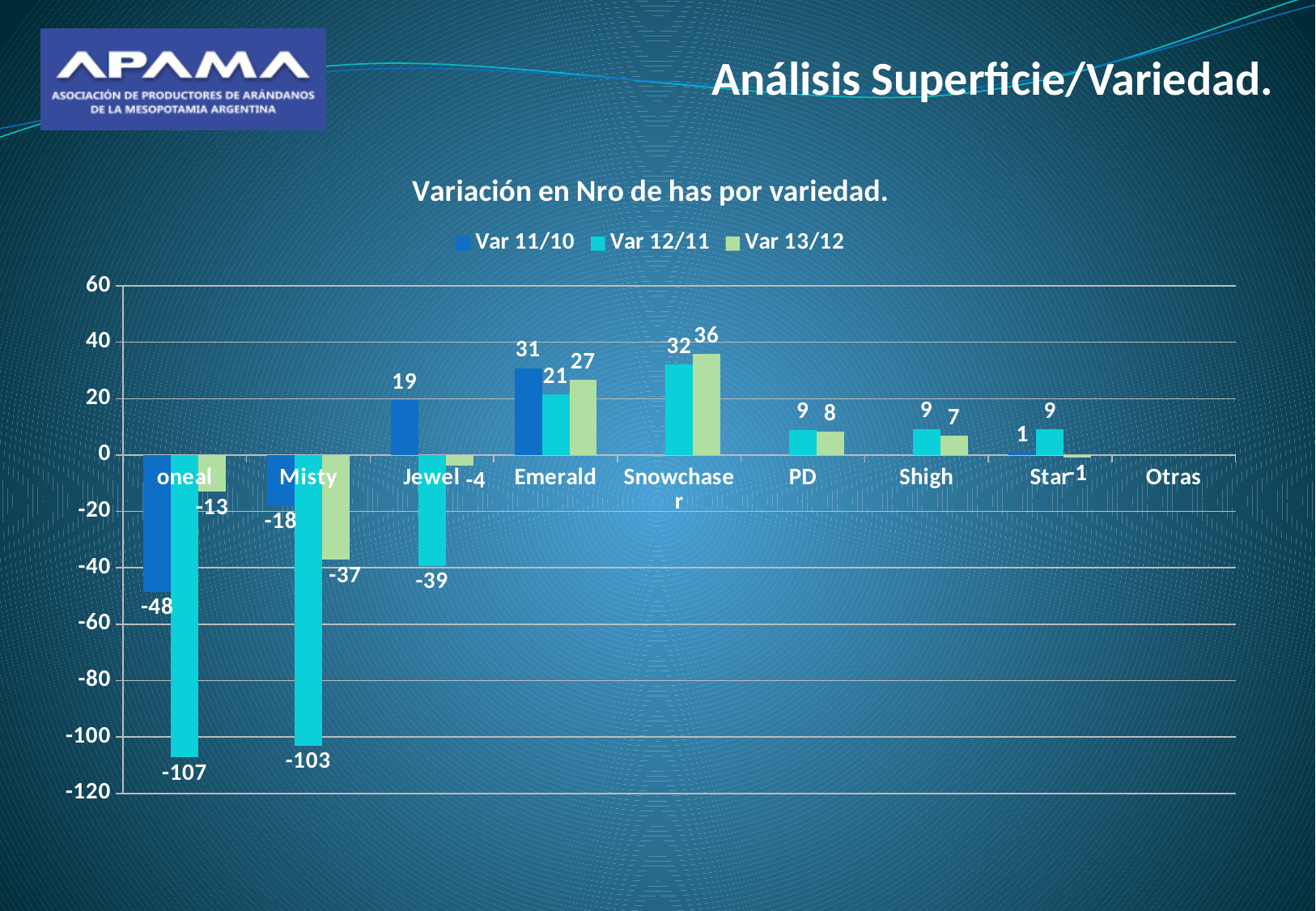
What is the Var 11/10 value for Emerald? 31 What is the Var 13/12 value for Snowchaser? 36 What is the Var 12/11 value for oneal? -107 Which is larger, the Var 13/12 value for oneal or the Var 13/12 value for Misty? oneal Which variety has the highest Var 13/12 value? Snowchaser What kind of chart is shown on the slide? Bar chart What is the difference between the Var 11/10 and Var 12/11 values for Emerald? 10 What is the title of the chart? Variación en Nro de has por variedad. How many series does the legend list? 3 What is the Var 12/11 value for Jewel? -39 Which variety has the lowest Var 12/11 value? oneal How many varieties are shown on the x axis? 9